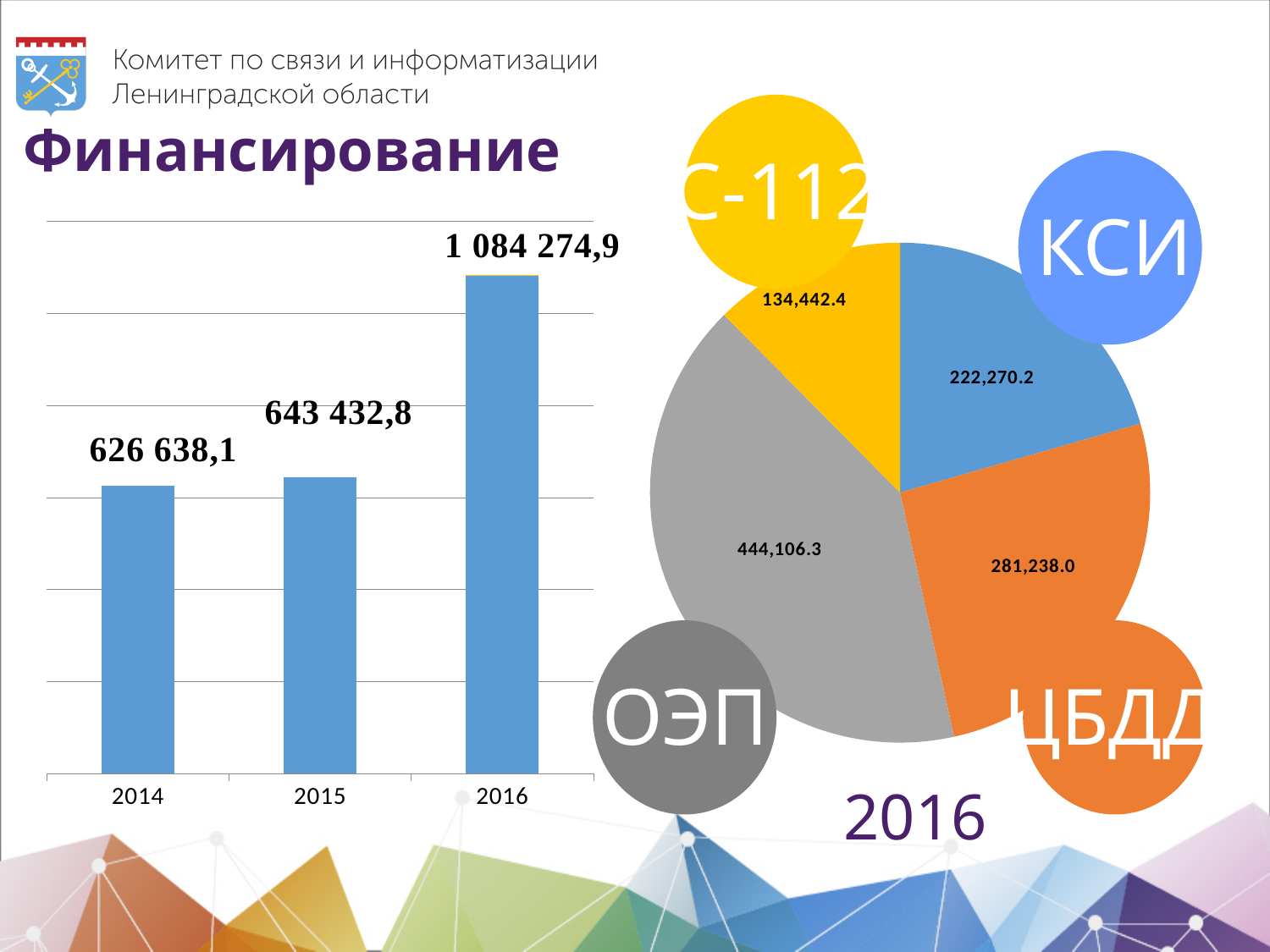
In the bar chart on the left, what is the difference between the 2016 and 2015 values? 440 842,1 What kind of chart is shown on the left of the slide? bar chart In the pie chart on the right, which slice is the smallest? С-112 In the bar chart on the left, what is the value for 2016? 1 084 274,9 In the pie chart on the right, what is the value of the ОЭП slice? 444,106.3 In the bar chart on the left, do the values rise or fall from 2014 to 2016? rise In the bar chart on the left, what is the value for 2014? 626 638,1 In the pie chart on the right, what is the difference between the ЦБДД and КСИ slices? 58,967.8 How many bars are in the bar chart on the left? 3 In the bar chart on the left, which year has the highest value? 2016 In the bar chart on the left, which year has the lowest value? 2014 In the pie chart on the right, what is the value of the КСИ slice? 222,270.2